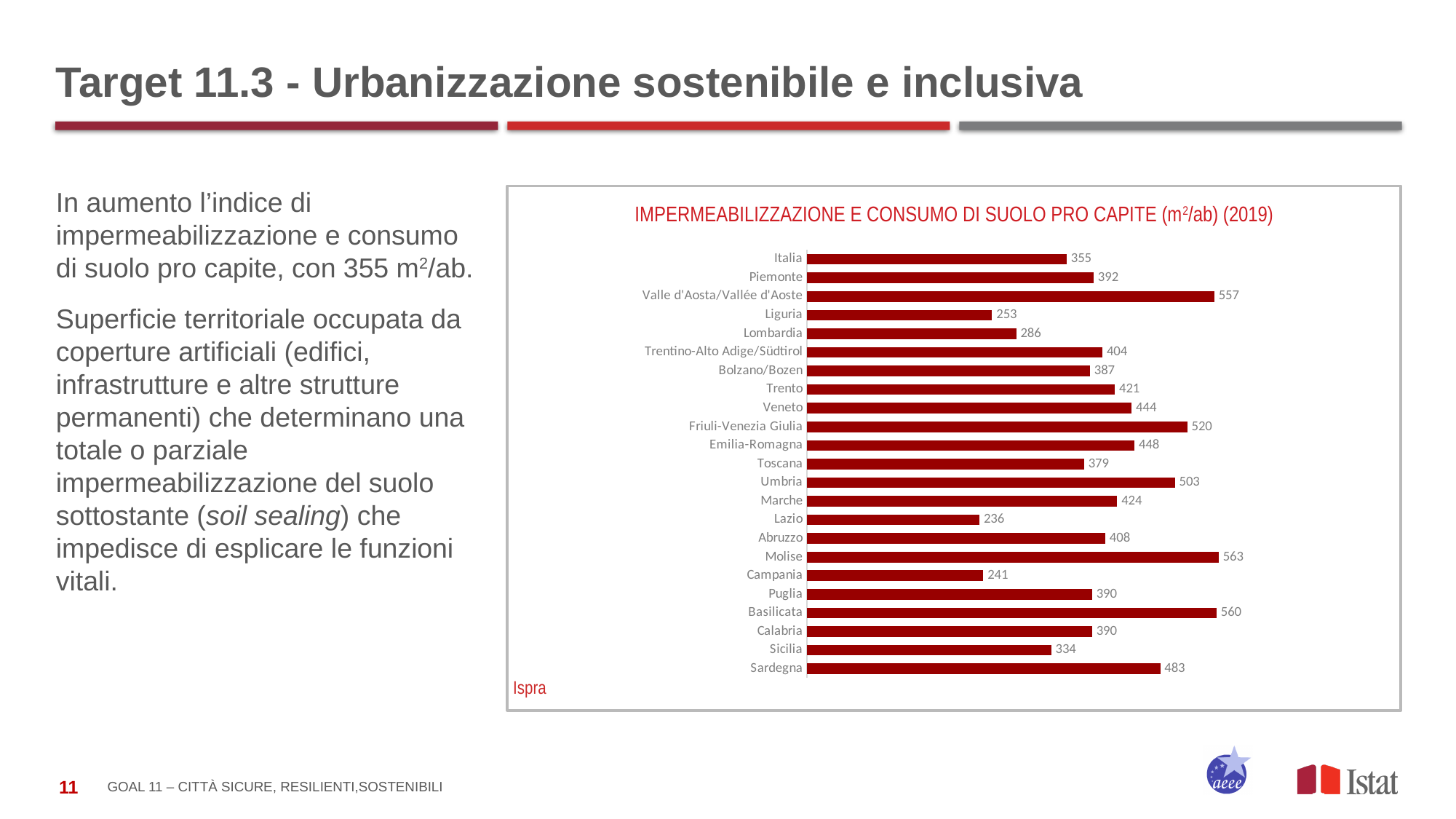
How many bars are shown in the chart? 23 What is the value for Italia? 355 What is the difference between the values for Valle d'Aosta/Vallée d'Aoste and Italia? 202 Which has a larger value, Campania or Sicilia? Sicilia What type of chart is shown on the slide? Bar chart What is the value for Lombardia? 286 What is the difference between the values for Molise and Lazio? 327 Which region has the lowest value? Lazio Which has a larger value, Umbria or Marche? Umbria Which region has the highest value? Molise What is the value for Sardegna? 483 What is the value for Friuli-Venezia Giulia? 520